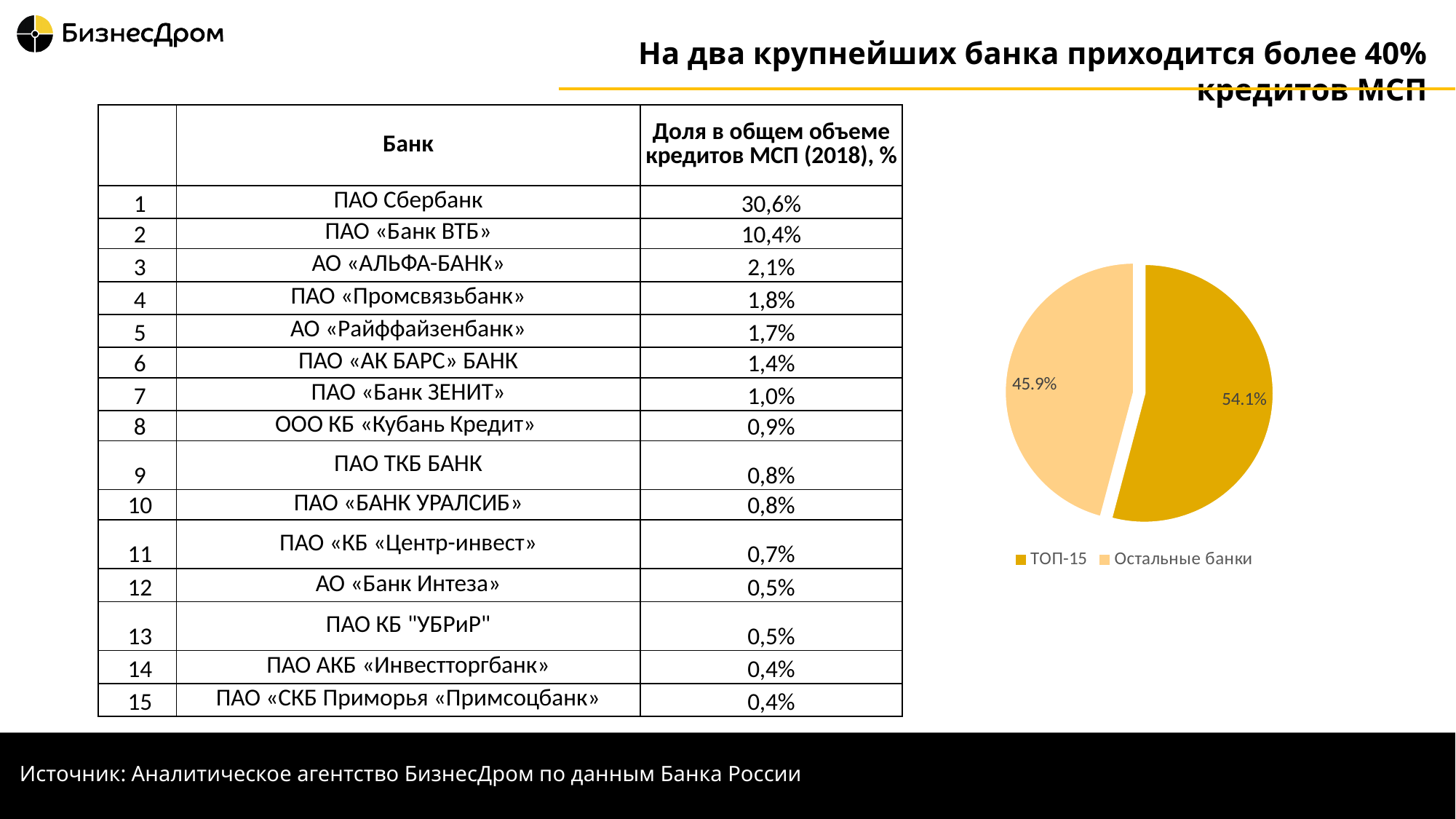
How many slices does the pie chart have? 2 How many entries does the legend of the pie chart list? 2 In the pie chart, what share is shown for ТОП-15? 54.1% In the pie chart, which is larger: ТОП-15 or Остальные банки? ТОП-15 Which slice of the pie chart is the largest? ТОП-15 What do the two slices of the pie chart add up to? 100% Which slice of the pie chart is the smallest? Остальные банки Is the share for ТОП-15 in the pie chart greater or less than 50%? greater In the pie chart, what is the difference in percentage points between the ТОП-15 slice and the Остальные банки slice? 8.2 percentage points What type of chart is shown on the right side of the slide? Pie chart In the pie chart, what share is shown for Остальные банки? 45.9% What colour is the ТОП-15 slice in the pie chart? Dark yellow (gold)